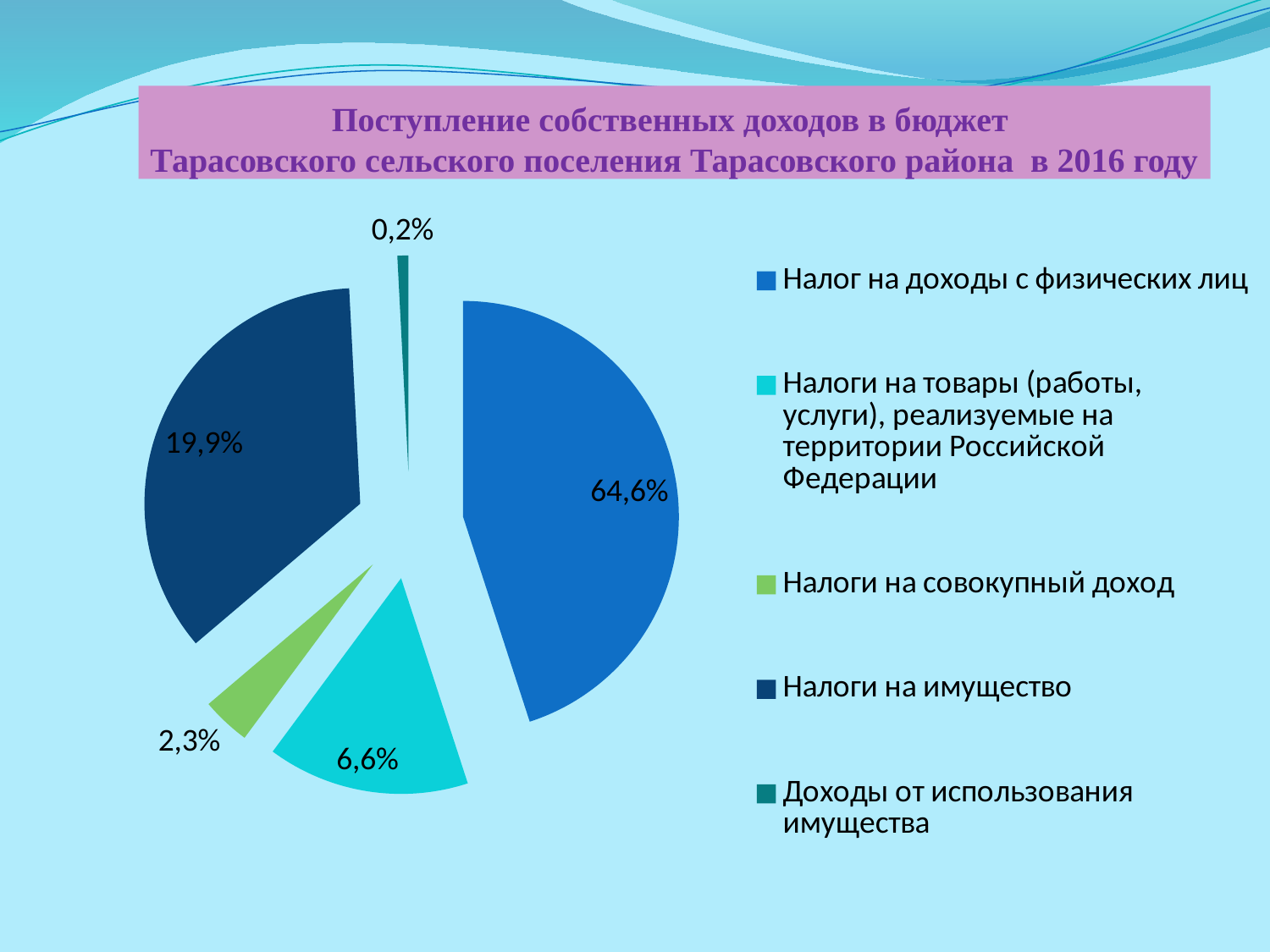
What is the difference between the shares of "Налог на доходы с физических лиц" and "Налоги на имущество"? 44,7% What share of the pie does "Налог на доходы с физических лиц" have? 64,6% What colour is the slice for "Налоги на совокупный доход"? green What is the value shown for "Налоги на товары (работы, услуги), реализуемые на территории Российской Федерации"? 6,6% Which category has the smallest slice of the pie? Доходы от использования имущества What is the value shown for "Налоги на совокупный доход"? 2,3% What kind of chart is shown on the slide? pie chart Which category has the largest slice of the pie? Налог на доходы с физических лиц What is the value shown for "Доходы от использования имущества"? 0,2% What is the value shown for "Налоги на имущество"? 19,9% Which is larger: the share of "Налоги на имущество" or the share of "Налоги на совокупный доход"? Налоги на имущество How many categories does the pie chart have? 5